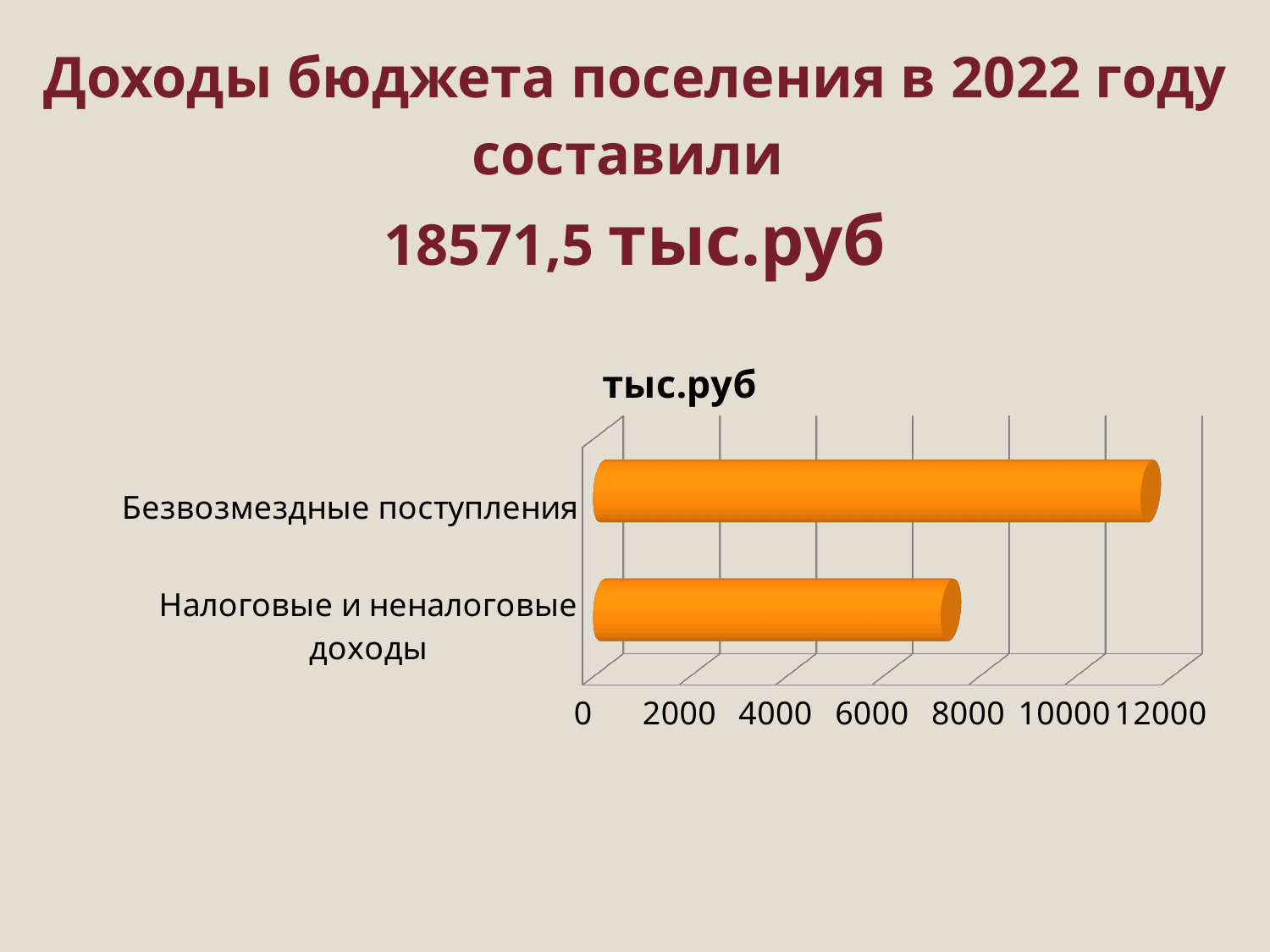
Which category has the highest value? Безвозмездные поступления Is the value for Налоговые и неналоговые доходы greater or less than 6000? greater What kind of chart is shown on the slide? bar chart Is the value for Безвозмездные поступления greater or less than 10000? greater What colour are the bars in the chart? orange Which category has the lowest value? Налоговые и неналоговые доходы What is the title of the chart? тыс.руб Is the value for Безвозмездные поступления greater or less than 12000? less Which is larger: the value for Безвозмездные поступления or the value for Налоговые и неналоговые доходы? Безвозмездные поступления How many categories does the chart show? 2